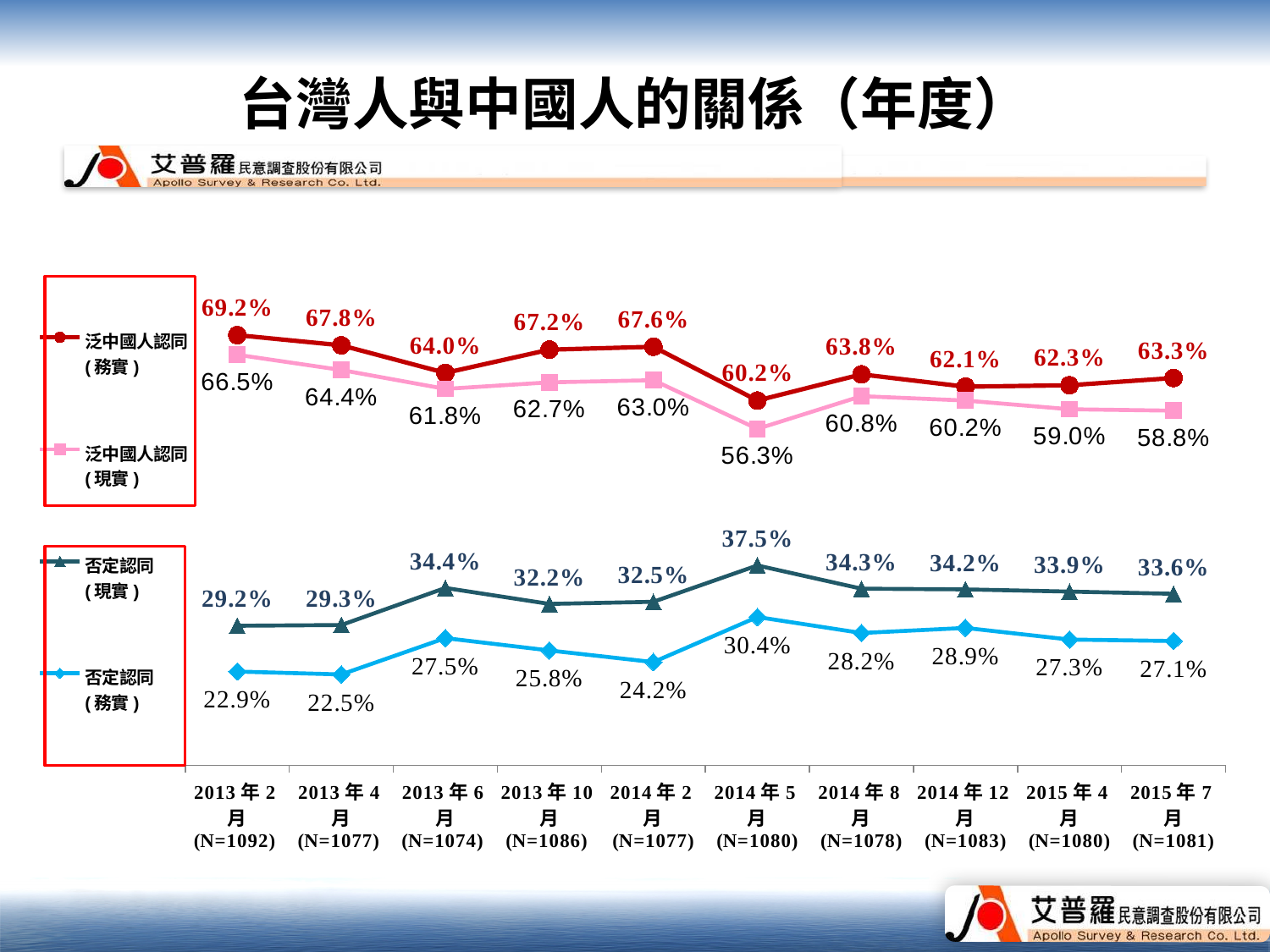
What is the value of 泛中國人認同(務實) in 2013年2月? 69.2% Which is larger in 2013年6月: 否定認同(現實) or 否定認同(務實)? 否定認同(現實) In which survey period does 泛中國人認同(現實) reach its lowest value? 2014年5月 How many survey periods are shown on the x axis? 10 What is the sample size (N) for the 2014年8月 survey? N=1078 What is the value of 否定認同(務實) in 2014年5月? 30.4% What is the difference between 泛中國人認同(務實) and 泛中國人認同(現實) in 2014年5月? 3.9% What kind of chart is shown on the slide? Line chart In which survey period does 否定認同(現實) reach its highest value? 2014年5月 What is the value of 泛中國人認同(現實) in 2015年7月? 58.8% How many series does the legend list? 4 Does 泛中國人認同(務實) rise or fall overall from 2013年2月 to 2015年7月? Fall